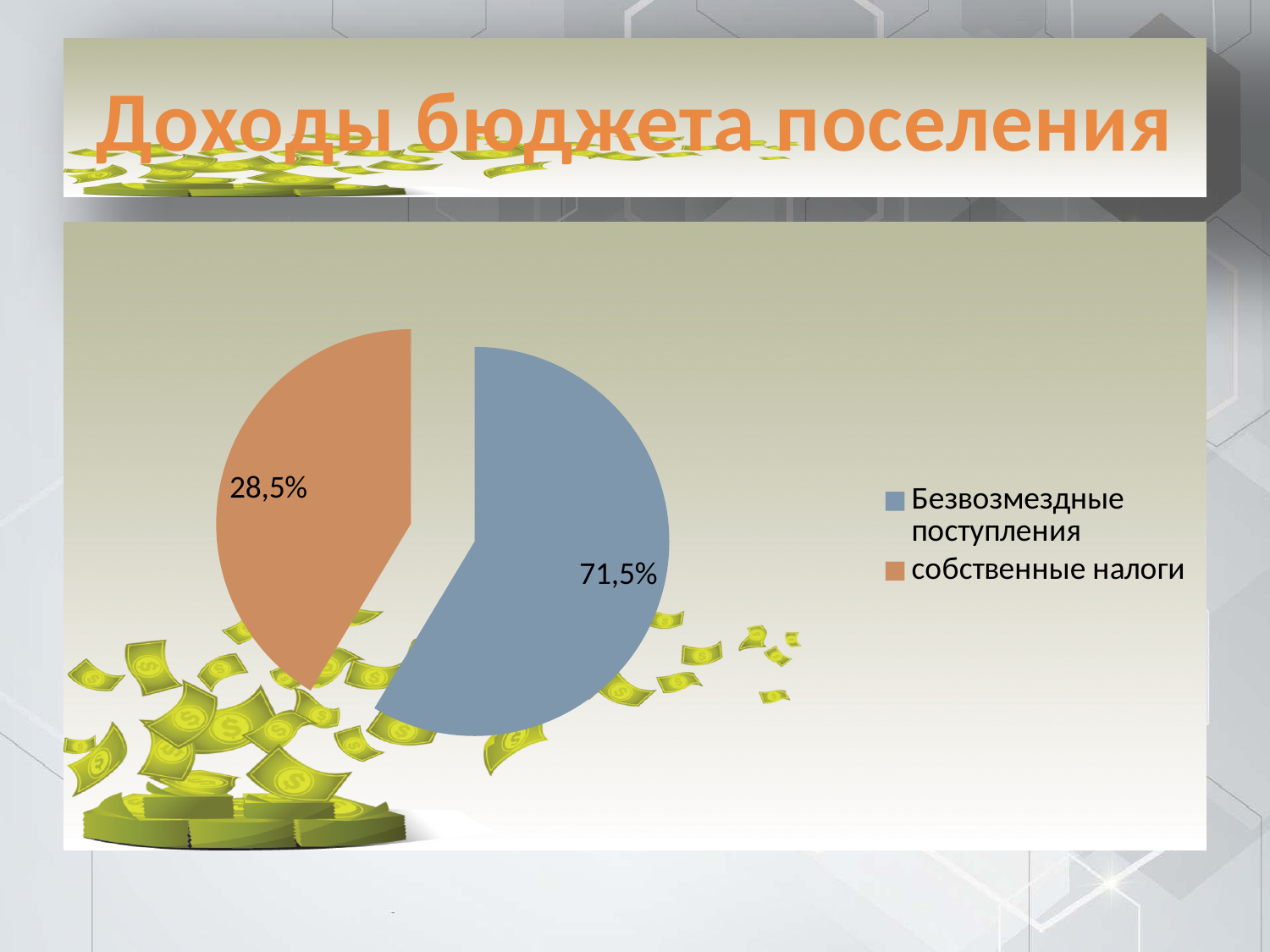
What share of the pie is labelled for Безвозмездные поступления? 71,5% Which category has the smallest slice of the pie? собственные налоги What kind of chart is shown on the slide? pie chart What is the title of the slide containing the chart? Доходы бюджета поселения How many entries does the legend list? 2 Which is larger: the slice for Безвозмездные поступления or the slice for собственные налоги? Безвозмездные поступления What colour is the slice for собственные налоги? orange What share of the pie is labelled for собственные налоги? 28,5% How many slices does the pie chart have? 2 Which category has the largest slice of the pie? Безвозмездные поступления What is the difference in percentage points between Безвозмездные поступления and собственные налоги? 43 percentage points